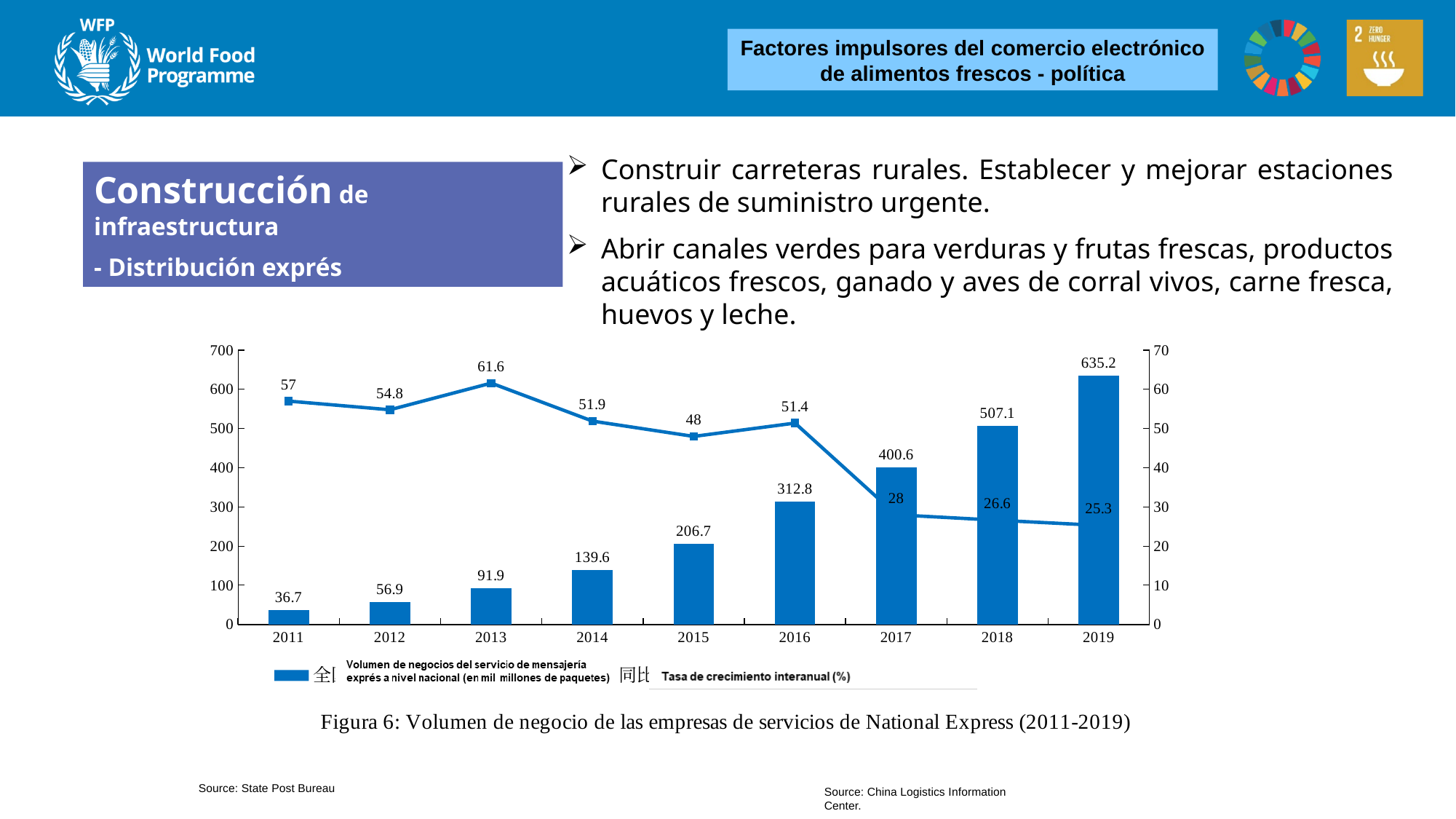
What is the national express delivery business volume shown for 2019? 635.2 What is the difference between the business volume in 2019 and in 2018? 128.1 What is the year-on-year growth rate (%) shown for 2013? 61.6 Do the business volume bars rise or fall from 2011 to 2019? Rise What kind of chart is used to show the business volume series? Bar chart Which year has the highest business volume bar? 2019 Which year has a higher year-on-year growth rate, 2014 or 2016? 2014 What is the figure caption below the chart? Figura 6: Volumen de negocio de las empresas de servicios de National Express (2011-2019) How many years are shown on the x axis of the chart? 9 Which year has the lowest year-on-year growth rate on the line? 2019 How many series does the chart legend list? 2 What is the business volume value shown for 2015? 206.7